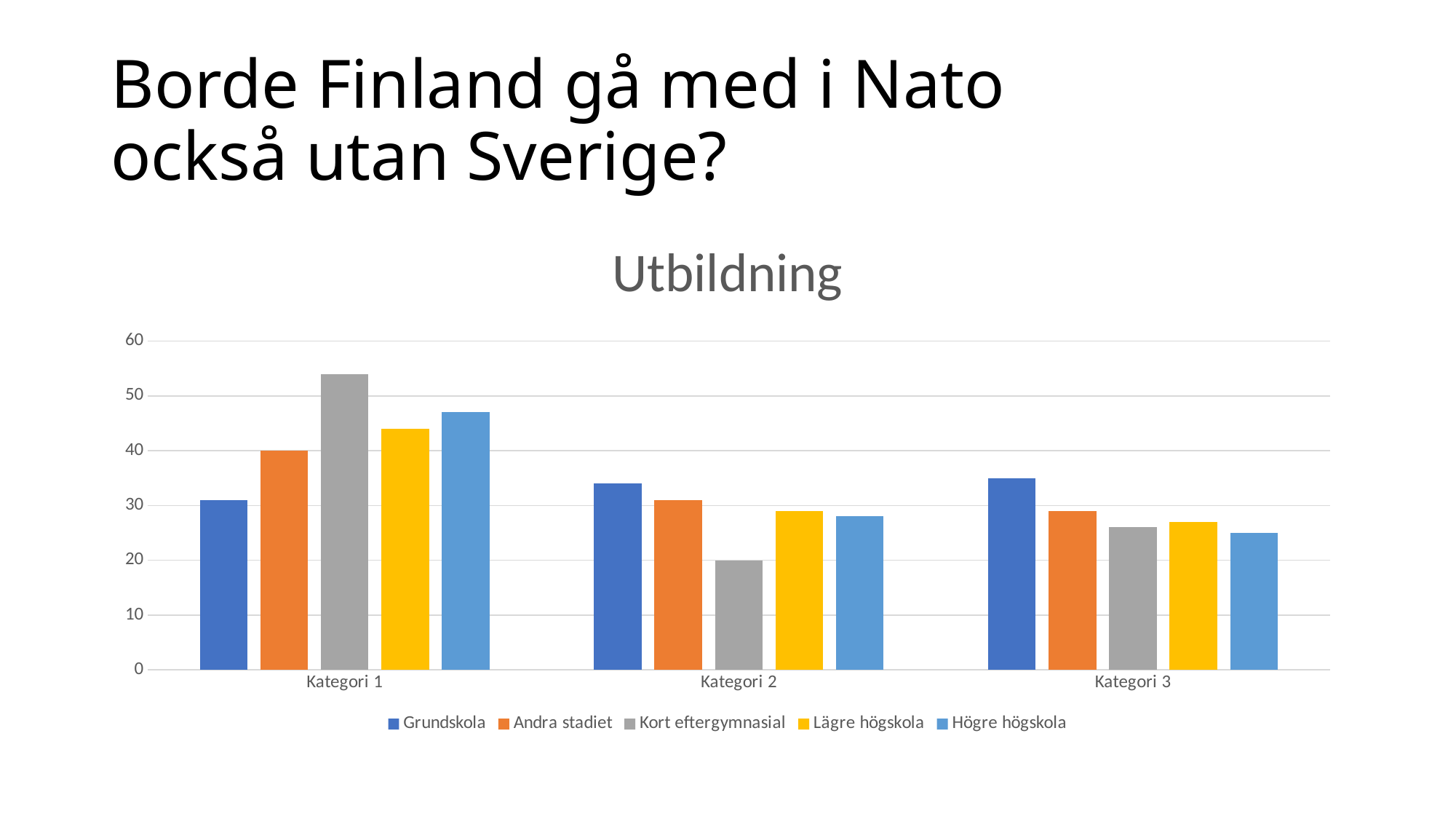
Is the value for Kort eftergymnasial in Kategori 1 greater or less than 50? greater How many series does the legend list? 5 What is the value for Kort eftergymnasial in Kategori 2? 20 In Kategori 1, which is larger: Grundskola or Högre högskola? Högre högskola How many categories are shown on the x axis? 3 Which series has the highest value in Kategori 3? Grundskola What is the title of the chart? Utbildning What kind of chart is shown on the slide? bar chart Which series has the lowest value in Kategori 2? Kort eftergymnasial What is the value for Andra stadiet in Kategori 1? 40 Which series has the highest value in Kategori 1? Kort eftergymnasial Is the value for Högre högskola in Kategori 3 greater or less than 30? less